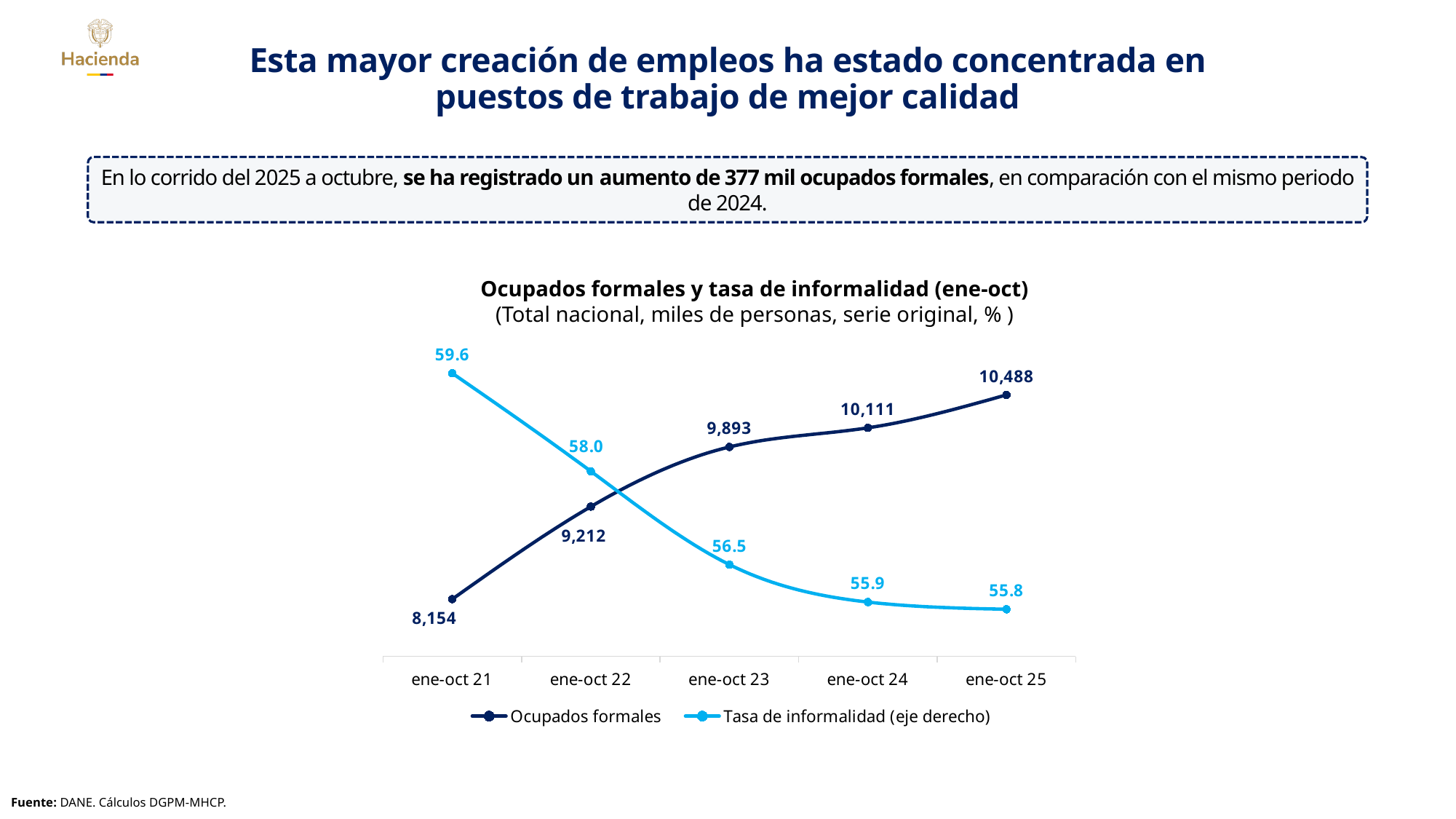
What is the difference in Ocupados formales between ene-oct 25 and ene-oct 24? 377 In which period is Ocupados formales lowest? ene-oct 21 What is the value of Ocupados formales for ene-oct 25? 10,488 What is the Tasa de informalidad for ene-oct 21? 59.6 What is the difference in Tasa de informalidad between ene-oct 21 and ene-oct 22? 1.6 What kind of chart is this? Line chart What is the Tasa de informalidad for ene-oct 24? 55.9 What is the value of Ocupados formales for ene-oct 23? 9,893 How many periods are shown on the x axis? 5 Which is larger, Ocupados formales in ene-oct 22 or in ene-oct 23? ene-oct 23 How many series does the legend list? 2 In which period is the Tasa de informalidad highest? ene-oct 21